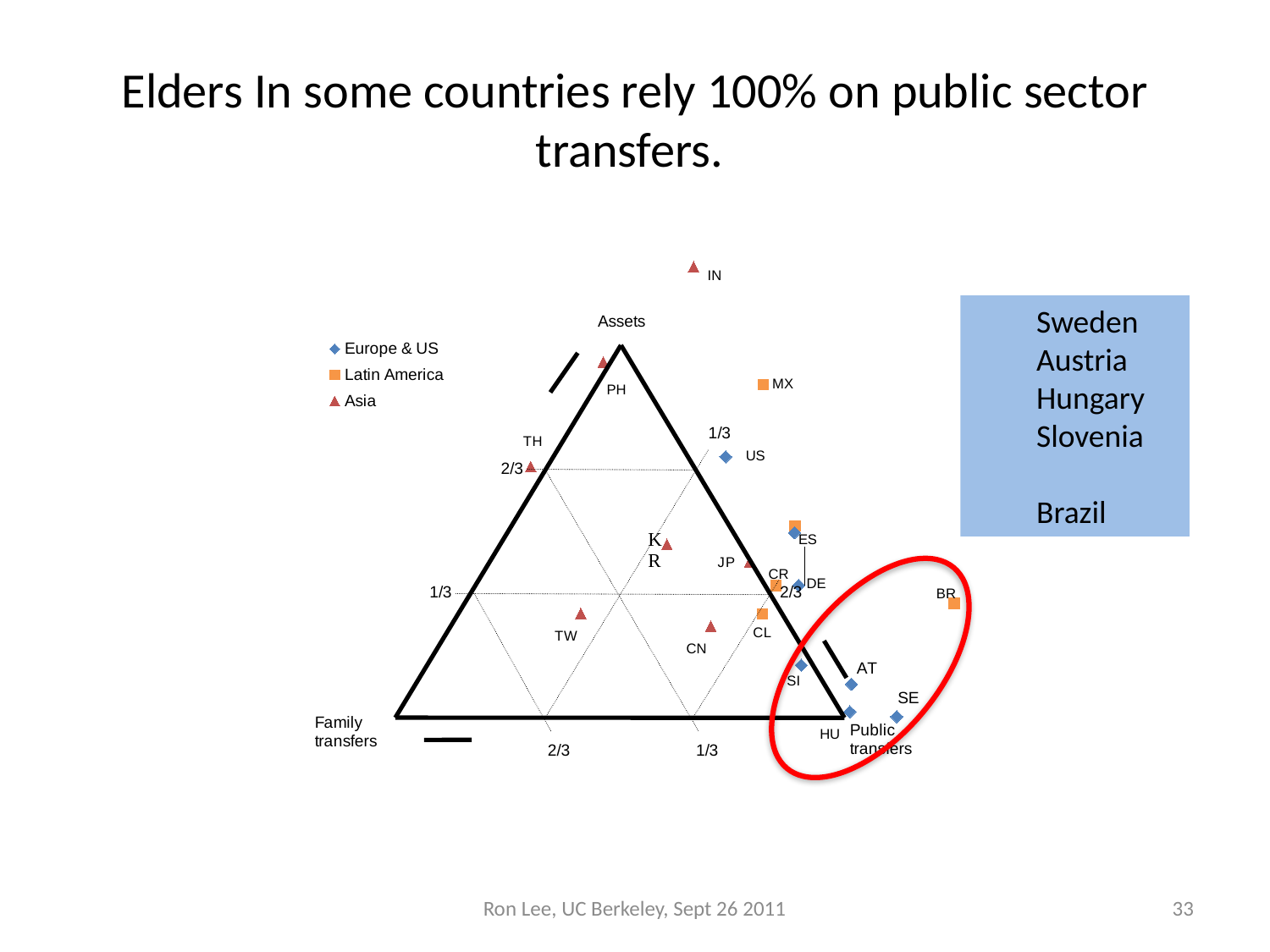
What are the labels of the three corners of the triangle? Assets, Family transfers, Public transfers What kind of chart is shown on the slide? ternary plot How many Asia points are plotted on the chart? 7 Which series does the point CN belong to? Asia How many Europe & US points are plotted on the chart? 7 How many series does the legend list? 3 What are the three series named in the legend? Europe & US, Latin America, Asia Which series does the point BR belong to? Latin America Which series does the point SE belong to? Europe & US Which series does the point MX belong to? Latin America Which series does the point US belong to? Europe & US